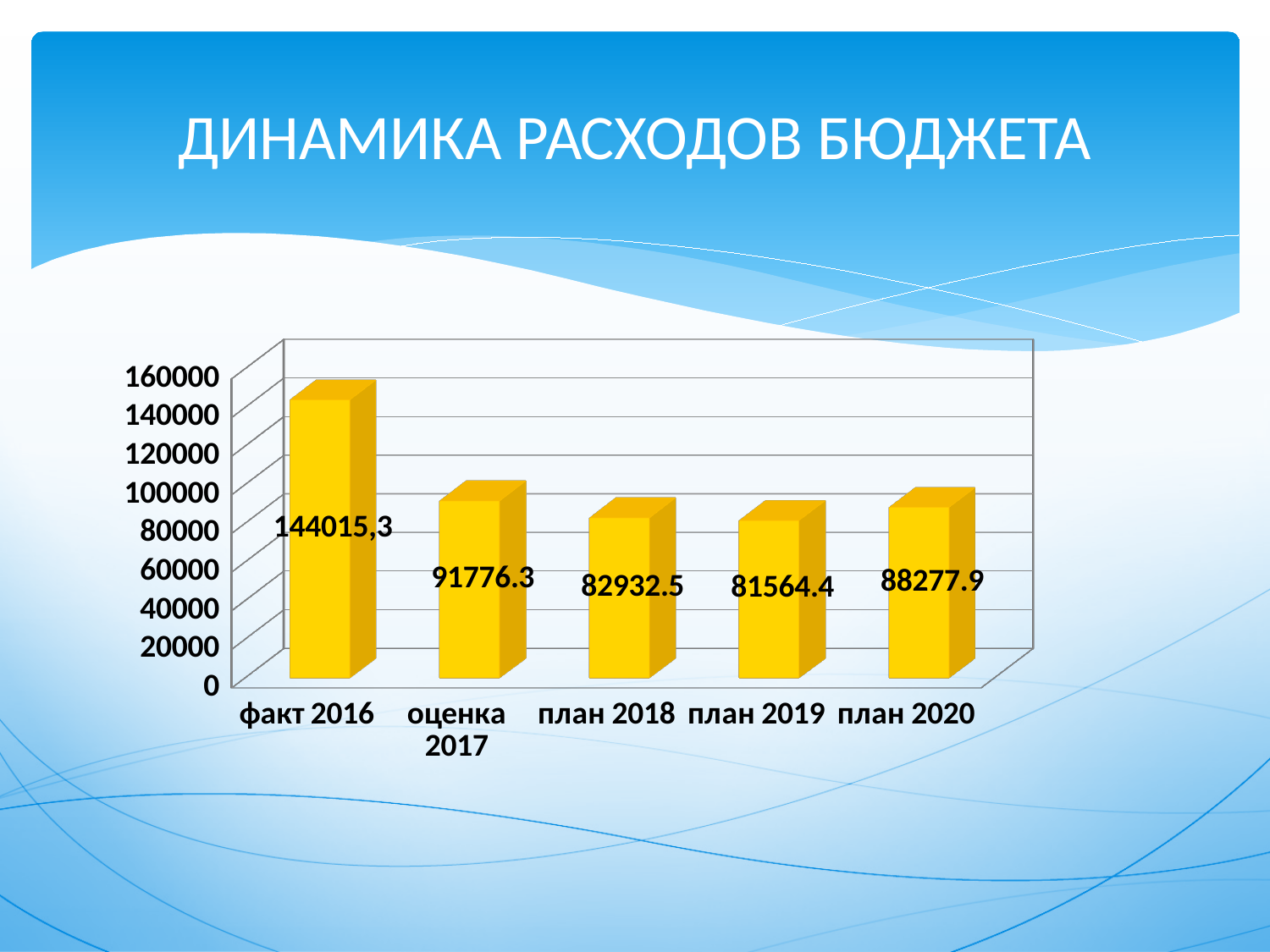
What is the value for факт 2016? 144015,3 Is the value for план 2019 greater or less than 100000? less Which category has the highest value? факт 2016 Which category has the lowest value? план 2019 What is the difference between the values for оценка 2017 and план 2018? 8843.8 What is the difference between the values for план 2020 and план 2019? 6713.5 What is the value for план 2020? 88277.9 What kind of chart is shown on the slide? bar chart How many categories are shown on the x axis? 5 What is the value for оценка 2017? 91776.3 Which is larger, the value for план 2018 or the value for план 2020? план 2020 What is the value for план 2019? 81564.4